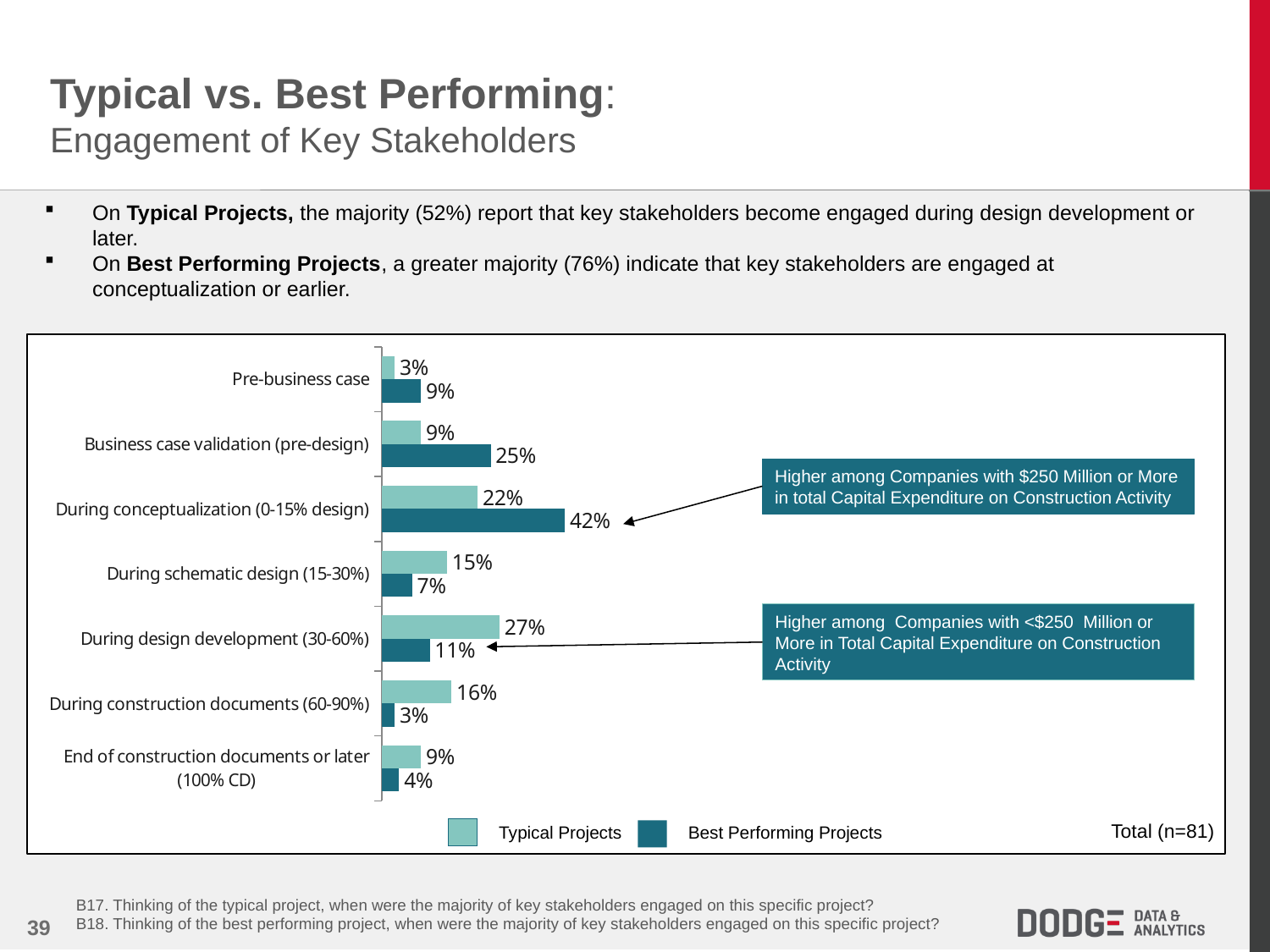
How many series does the legend list? 2 What is the difference between Typical Projects and Best Performing Projects in the 'During construction documents (60-90%)' category? 13% What is the value for Best Performing Projects in the 'Business case validation (pre-design)' category? 25% Which category has the lowest value for Best Performing Projects? During construction documents (60-90%) How many categories are shown on the chart? 7 What kind of chart is shown on the slide? Bar chart Which category has the highest value for Typical Projects? During design development (30-60%) What is the value for Typical Projects in the 'During design development (30-60%)' category? 27% What is the value for Best Performing Projects in the 'During conceptualization (0-15% design)' category? 42% In the 'During schematic design (15-30%)' category, which series has the larger value, Typical Projects or Best Performing Projects? Typical Projects What is the sample size shown on the chart? n=81 What is the difference between Best Performing Projects and Typical Projects in the 'During conceptualization (0-15% design)' category? 20%